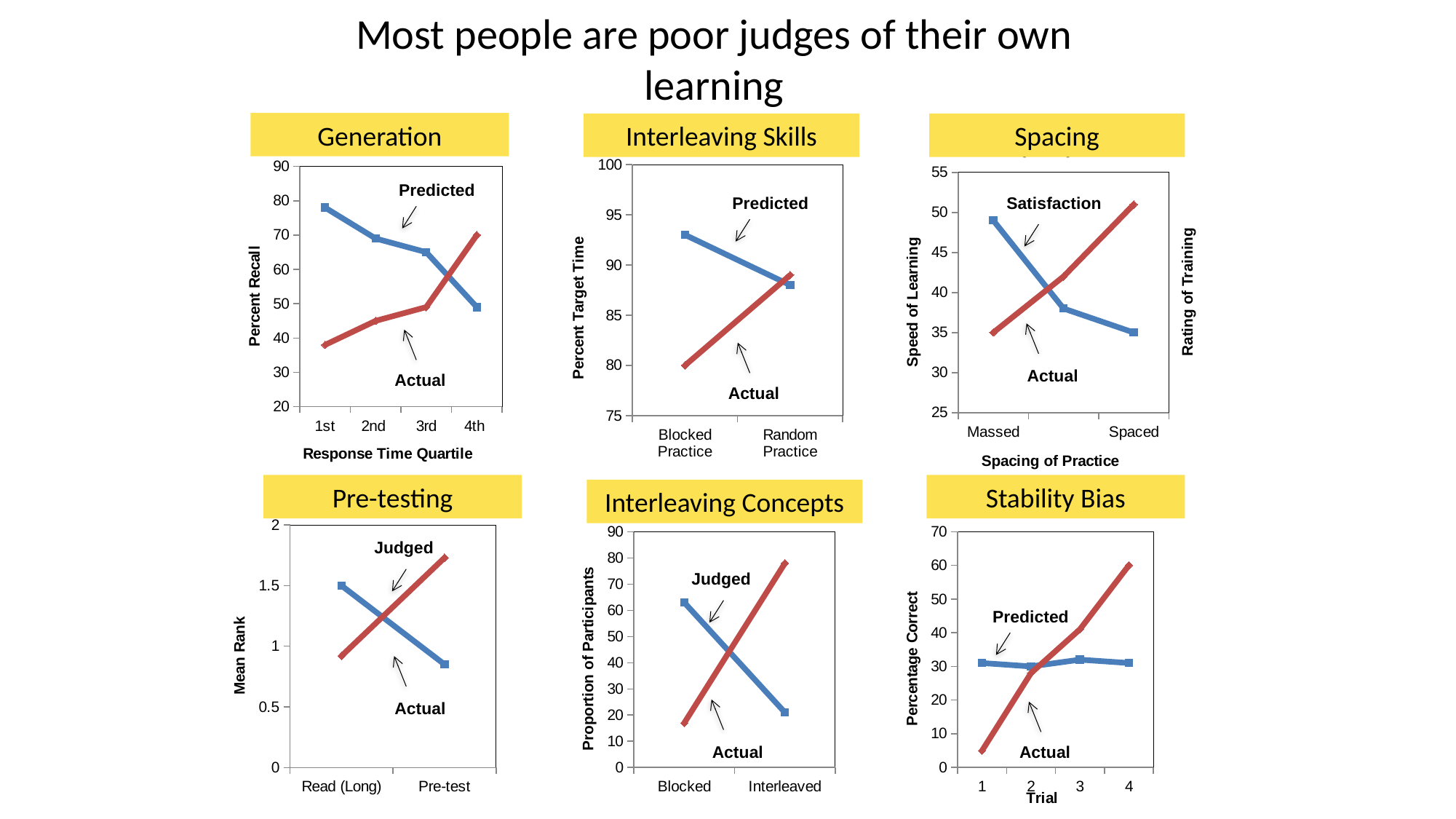
In the Generation chart, is the Actual value for the 1st quartile greater or less than 40? less In the Spacing chart, which is larger for Massed practice: Satisfaction or Actual? Satisfaction In the Generation chart, does the Predicted line rise or fall from the 1st to the 4th quartile? fall In the Interleaving Concepts chart, is the Judged value for Blocked greater or less than 60? greater In the Generation chart, how many response time quartiles are shown on the x axis? 4 In the Interleaving Skills chart, is the Predicted value for Blocked Practice greater or less than 90? greater In the Stability Bias chart, how many trials are shown on the x axis? 4 In the Interleaving Skills chart, does the Actual line rise or fall from Blocked Practice to Random Practice? rise In the Stability Bias chart, what is the label of the y axis? Percentage Correct In the Pre-testing chart, which is larger for Pre-test: Judged or Actual? Judged What type of chart is the Generation chart? line chart